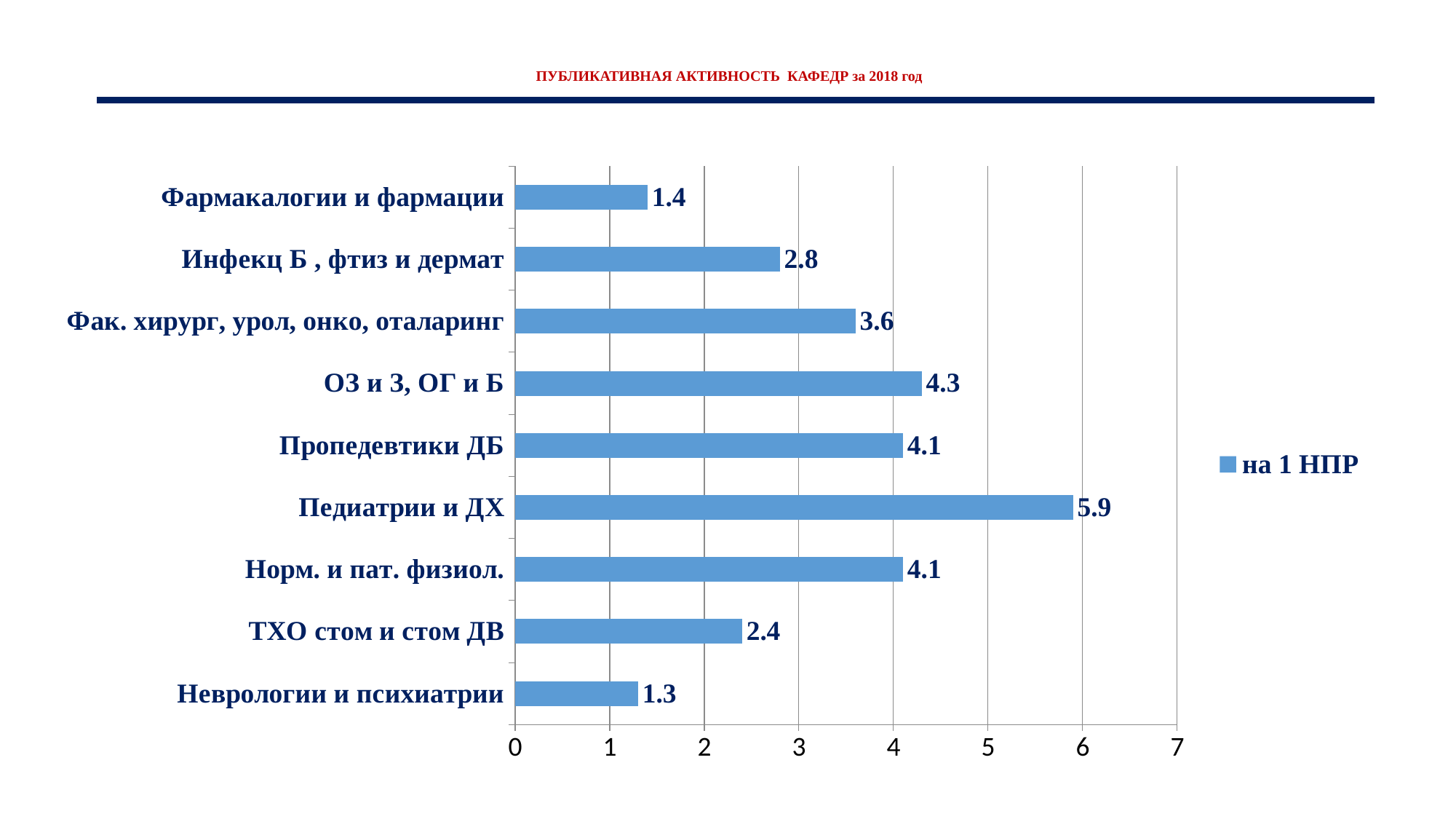
Which is larger, the value for Инфекц Б , фтиз и дермат or the value for ТХО стом и стом ДВ? Инфекц Б , фтиз и дермат How many series does the legend list? 1 What is the value for Неврологии и психиатрии? 1.3 How many categories are shown in the chart? 9 What is the value for Фак. хирург, урол, онко, оталаринг? 3.6 Which category has the highest value? Педиатрии и ДХ Is the value for Пропедевтики ДБ greater or less than 4? greater Which category has the lowest value? Неврологии и психиатрии What is the difference between the values for Педиатрии и ДХ and ОЗ и З, ОГ и Б? 1.6 What kind of chart is shown on the slide? bar chart What is the value for Педиатрии и ДХ? 5.9 What is the legend entry of the chart? на 1 НПР